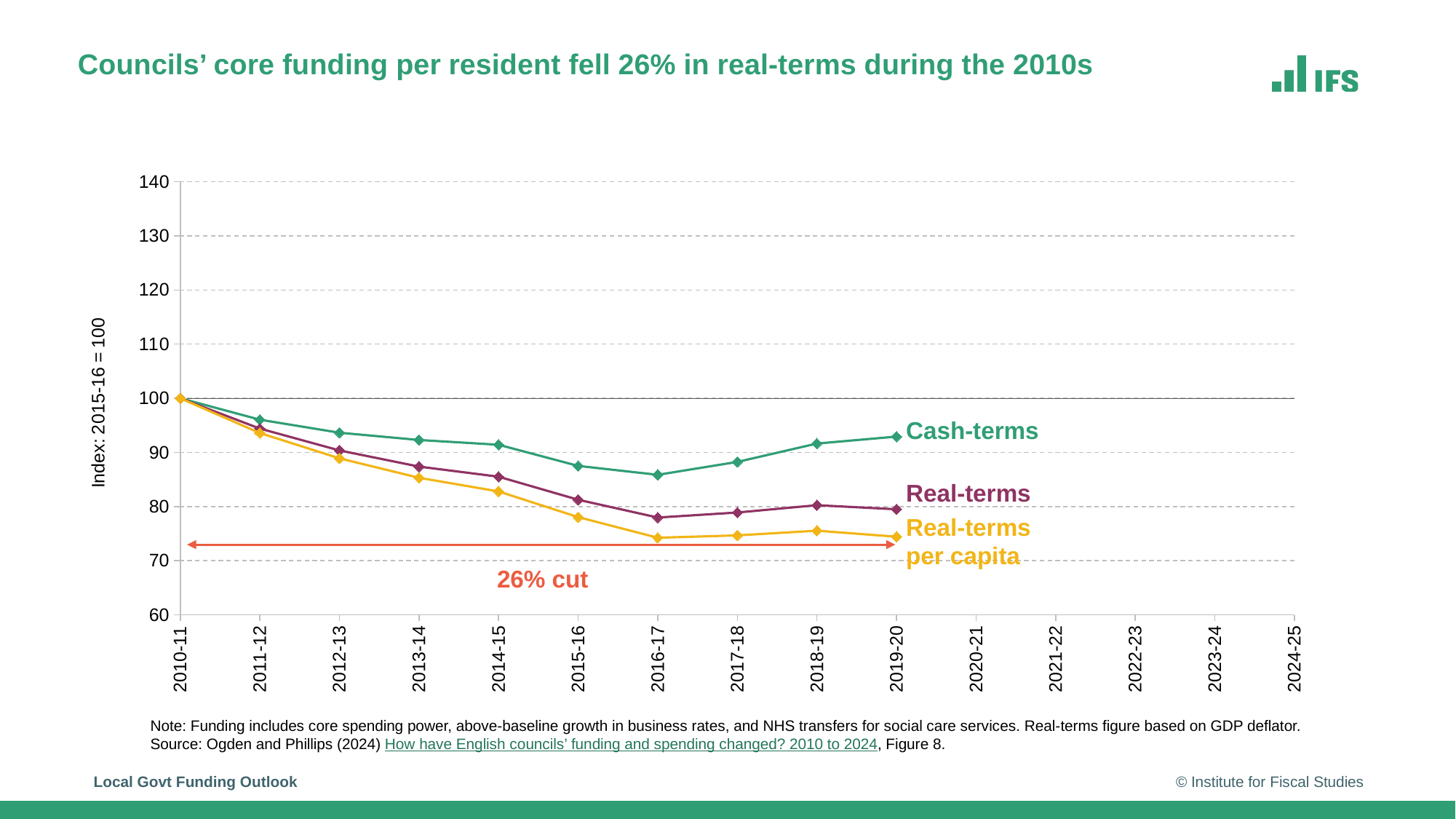
What is the value of the Real-terms per capita series in 2010-11? 100 Is the value for Cash-terms in 2019-20 greater or less than 90? greater In 2019-20, which series is higher, Cash-terms or Real-terms? Cash-terms What is the value of the Cash-terms series in 2010-11? 100 In which year does the Cash-terms series reach its lowest value? 2016-17 Is the value for Real-terms per capita in 2019-20 greater or less than 80? less How many series are plotted on the chart? 3 Does the Cash-terms series rise or fall between 2010-11 and 2016-17? fall Is the value for Cash-terms in 2016-17 greater or less than 90? less What kind of chart is shown on the slide? line chart What percentage cut is labelled by the red arrow on the chart? 26% cut